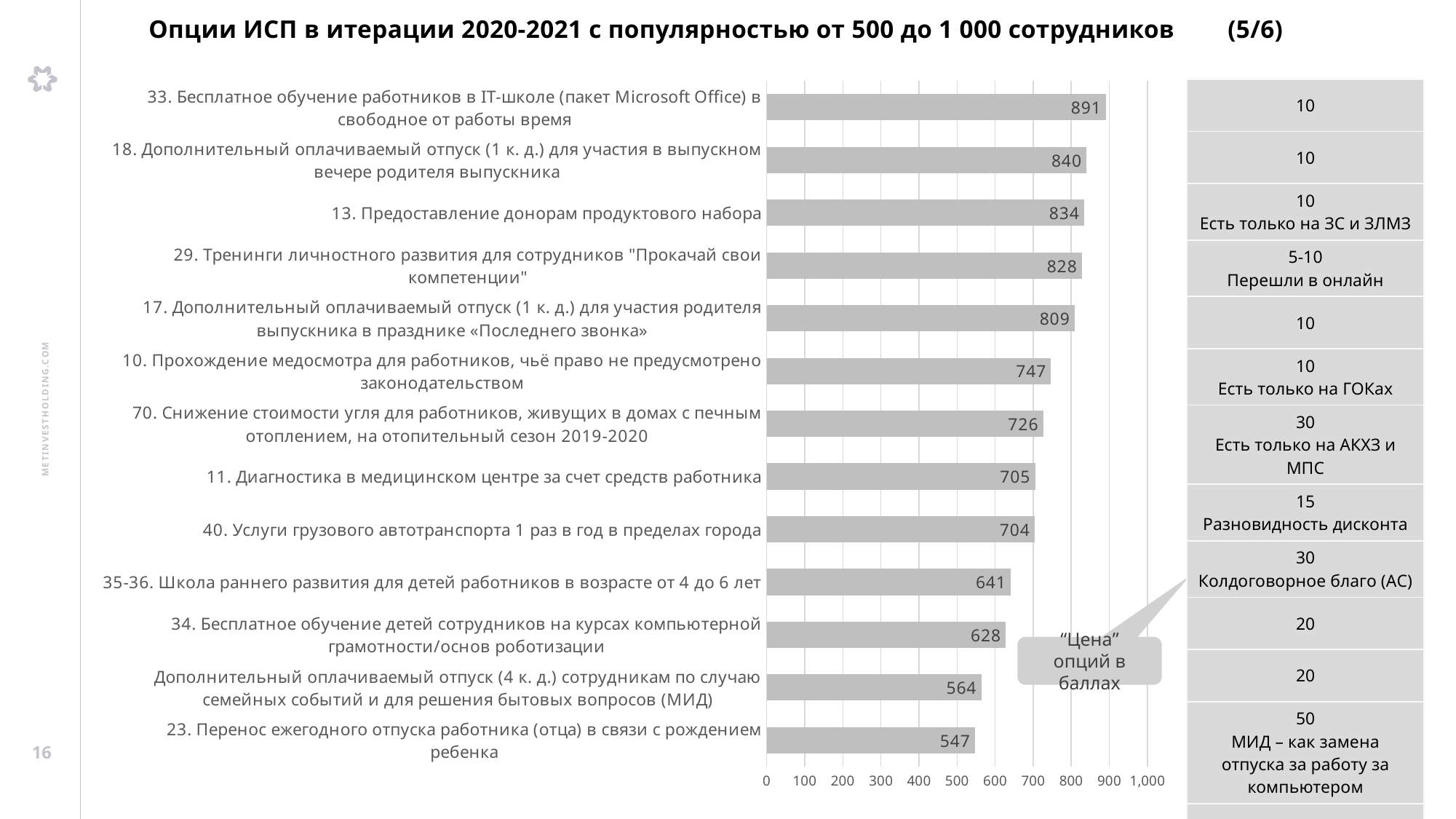
Which option has the lowest value on the chart? 23. Перенос ежегодного отпуска работника (отца) в связи с рождением ребенка What type of chart is shown on the slide? Bar chart What is the difference between the values for option 33 (891) and option 18 (840)? 51 What is the maximum value shown on the horizontal axis of the chart? 1,000 Which has a larger value: option 29 (Тренинги личностного развития) or option 11 (Диагностика в медицинском центре)? 29. Тренинги личностного развития для сотрудников "Прокачай свои компетенции" Is the value for option 17 (Дополнительный оплачиваемый отпуск для участия в празднике «Последнего звонка») greater or less than 800? greater What is the value for option 23 (Перенос ежегодного отпуска работника (отца) в связи с рождением ребенка)? 547 How many options (bars) are shown on the chart? 13 What is the value for option 13 (Предоставление донорам продуктового набора)? 834 What is the difference between the values for option 10 (Прохождение медосмотра) and option 34 (Бесплатное обучение детей сотрудников)? 119 Which option has the highest value on the chart? 33. Бесплатное обучение работников в IT-школе (пакет Microsoft Office) в свободное от работы время What is the value for option 70 (Снижение стоимости угля для работников, живущих в домах с печным отоплением)? 726